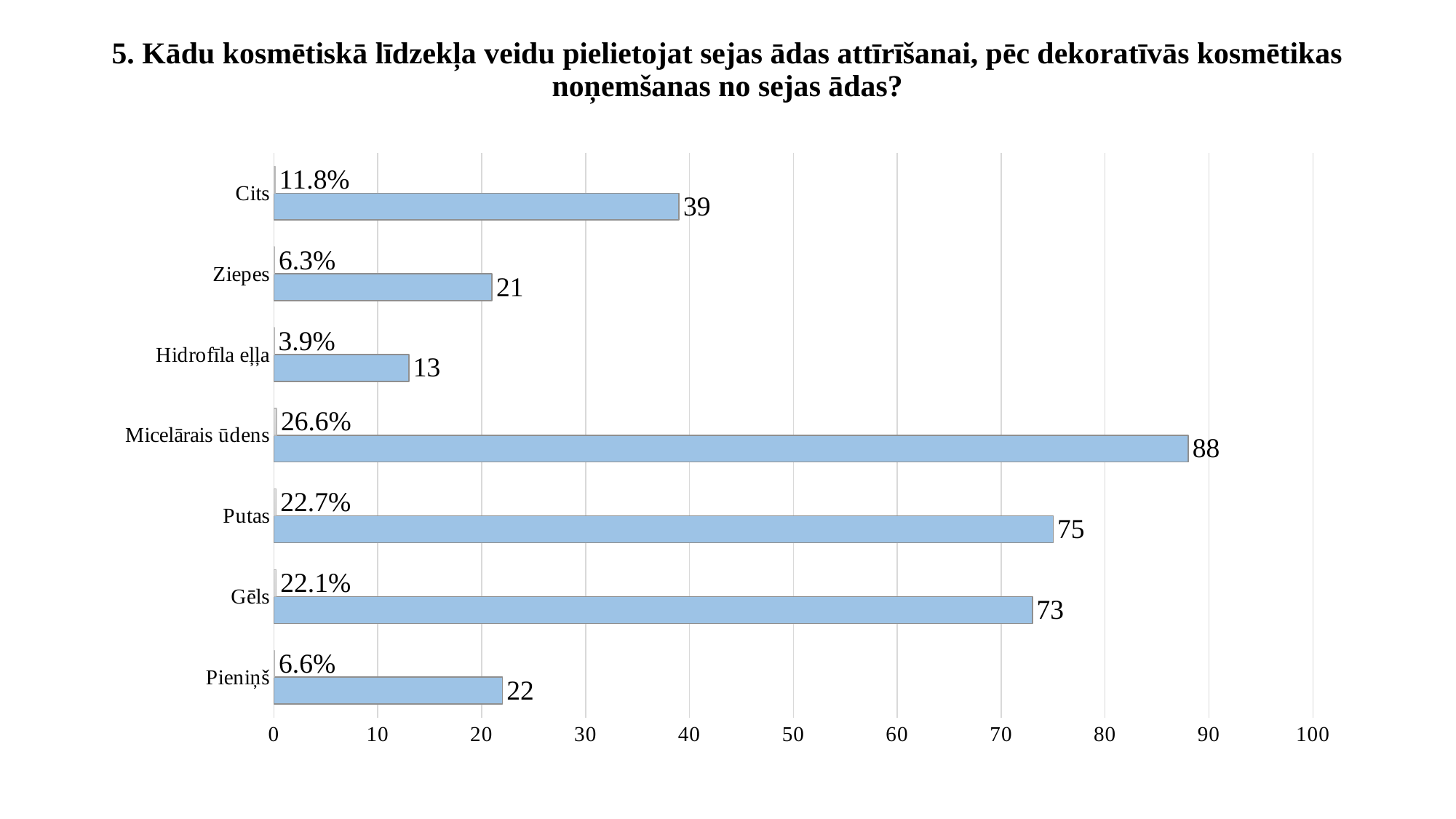
What is the difference between the counts for Cits and Ziepes? 18 Which has a larger count, Pieniņš or Ziepes? Pieniņš Is the count for Gēls greater or less than 70? greater What is the difference between the counts for Micelārais ūdens and Putas? 13 What is the count value for Micelārais ūdens? 88 What kind of chart is shown on the slide? bar chart Which category has the lowest count? Hidrofīla eļļa What percentage is shown for Putas? 22.7% Which category has the highest count? Micelārais ūdens What percentage is shown for Cits? 11.8% What is the count value for Hidrofīla eļļa? 13 How many categories are shown in the chart? 7